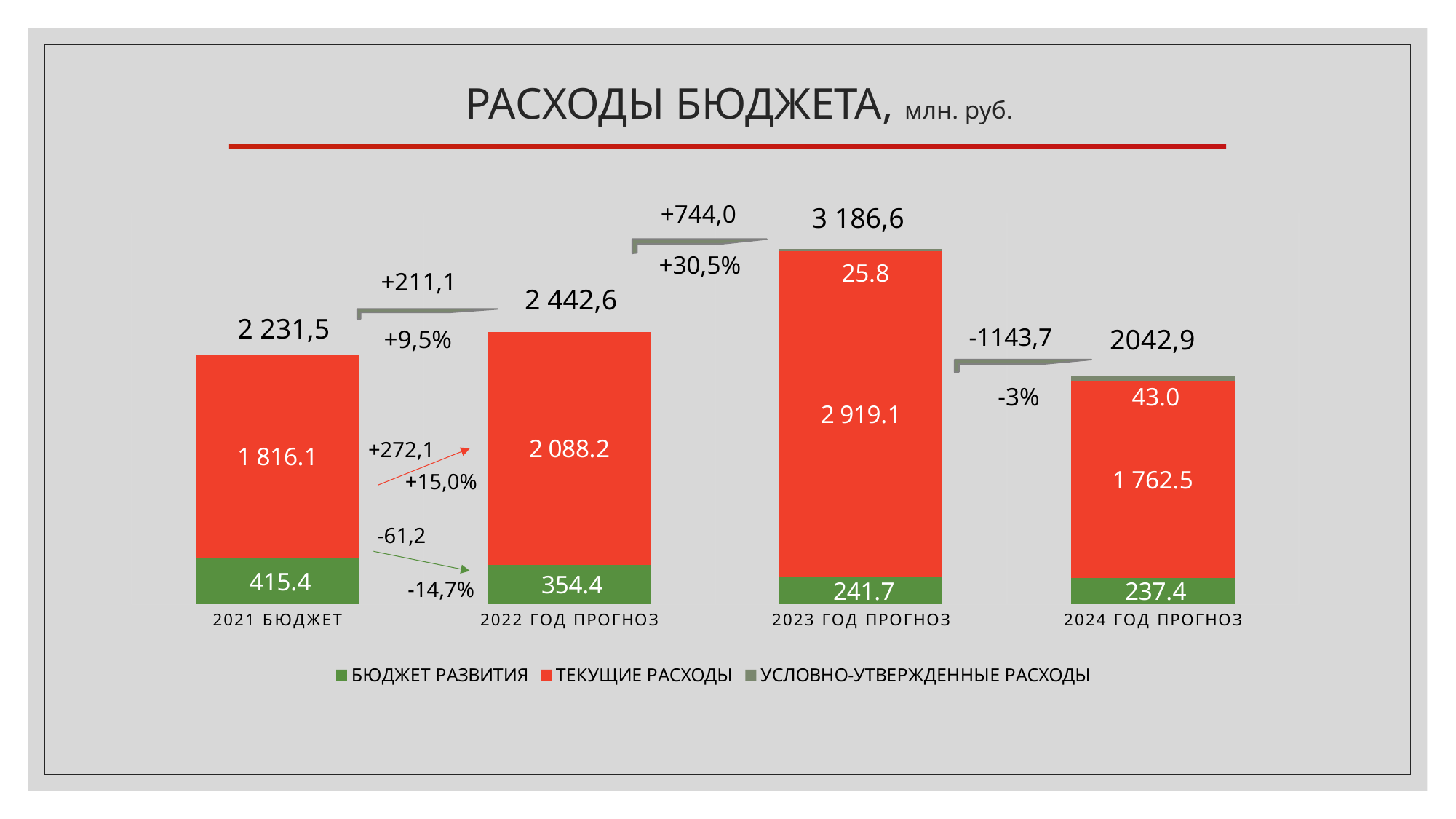
What type of chart is shown on the slide? stacked bar chart What is the value of БЮДЖЕТ РАЗВИТИЯ for 2021 БЮДЖЕТ? 415.4 Which is larger: БЮДЖЕТ РАЗВИТИЯ in 2021 БЮДЖЕТ or in 2022 ГОД ПРОГНОЗ? 2021 БЮДЖЕТ What is the total shown above the bar for 2022 ГОД ПРОГНОЗ? 2 442,6 What is the title of the chart? РАСХОДЫ БЮДЖЕТА, млн. руб. What is the value of УСЛОВНО-УТВЕРЖДЕННЫЕ РАСХОДЫ for 2024 ГОД ПРОГНОЗ? 43.0 What is the value of ТЕКУЩИЕ РАСХОДЫ for 2023 ГОД ПРОГНОЗ? 2 919.1 Which year has the highest total budget expenditure? 2023 ГОД ПРОГНОЗ How many series does the legend list? 3 What is the difference between ТЕКУЩИЕ РАСХОДЫ in 2022 ГОД ПРОГНОЗ and 2021 БЮДЖЕТ? 272.1 Which year has the lowest value for БЮДЖЕТ РАЗВИТИЯ? 2024 ГОД ПРОГНОЗ How many categories (years) are shown on the x axis? 4